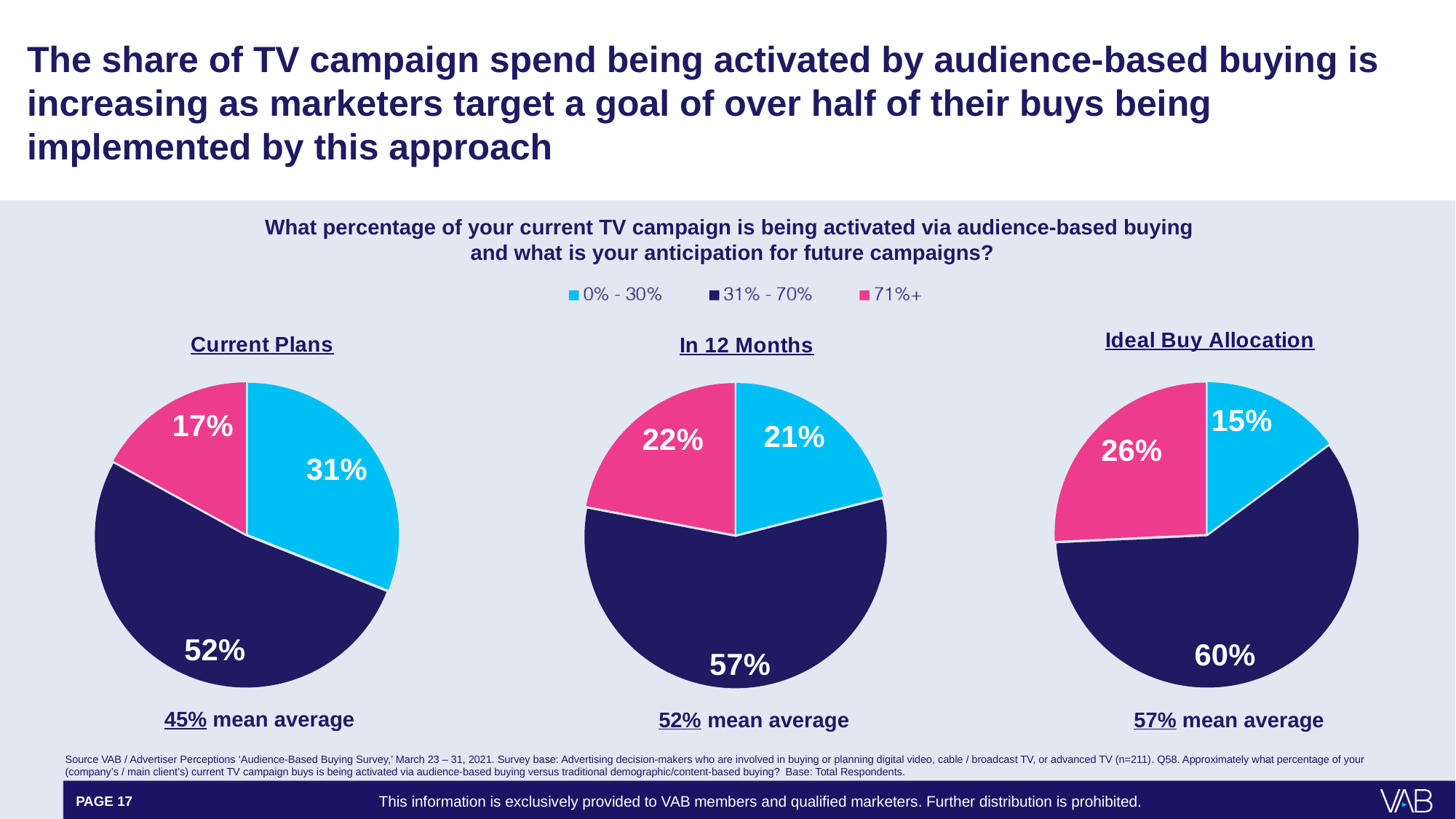
How many categories does the legend list? 3 In the 'In 12 Months' pie chart, what share is shown for the 71%+ category? 22% Which is larger in the 'Current Plans' pie chart: the 0% - 30% slice or the 71%+ slice? 0% - 30% In the 'Ideal Buy Allocation' pie chart, which category has the largest slice? 31% - 70% In the 'Current Plans' pie chart, what share is shown for the 31% - 70% category? 52% What type of chart is used for 'Ideal Buy Allocation'? Pie chart How many slices does the 'In 12 Months' pie chart have? 3 In the 'Ideal Buy Allocation' pie chart, what share is shown for the 0% - 30% category? 15% In the 'In 12 Months' pie chart, what is the difference between the 31% - 70% slice and the 0% - 30% slice? 36% What is the mean average shown below the 'In 12 Months' pie chart? 52% Which colour represents the 71%+ category in the legend? Pink In the 'Current Plans' pie chart, which category has the smallest slice? 71%+